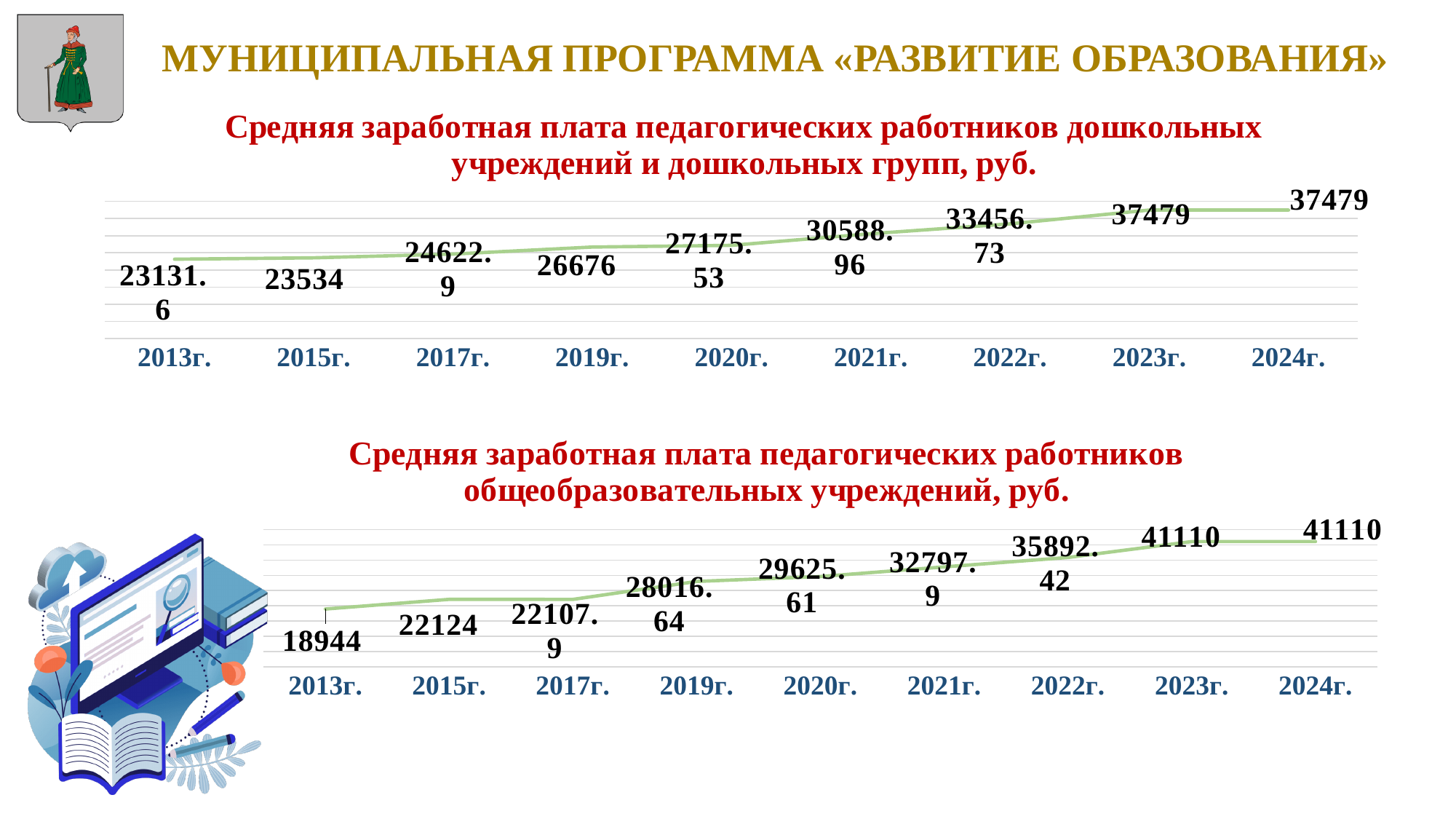
In the top chart (preschool teachers' average salary), which is larger: the value for 2019г. or the value for 2021г.? 2021г. In the top chart (preschool teachers' average salary), what is the value for 2013г.? 23131.6 In the top chart (preschool teachers' average salary), what is the value for 2024г.? 37479 In the bottom chart (general education teachers' average salary), what is the difference between the 2024г. value and the 2013г. value? 22166 In the top chart (preschool teachers' average salary), what is the difference between the 2023г. value and the 2022г. value? 4022.27 How many years are plotted on the bottom chart (general education teachers' average salary)? 9 In the top chart (preschool teachers' average salary), which year has the lowest value? 2013г. In the top chart (preschool teachers' average salary), what is the value for 2021г.? 30588.96 In the bottom chart (general education teachers' average salary), what is the value for 2022г.? 35892.42 In the bottom chart (general education teachers' average salary), what is the value for 2019г.? 28016.64 In the bottom chart (general education teachers' average salary), which year has the lowest value? 2013г. What kind of chart is the top chart (preschool teachers' average salary)? line chart